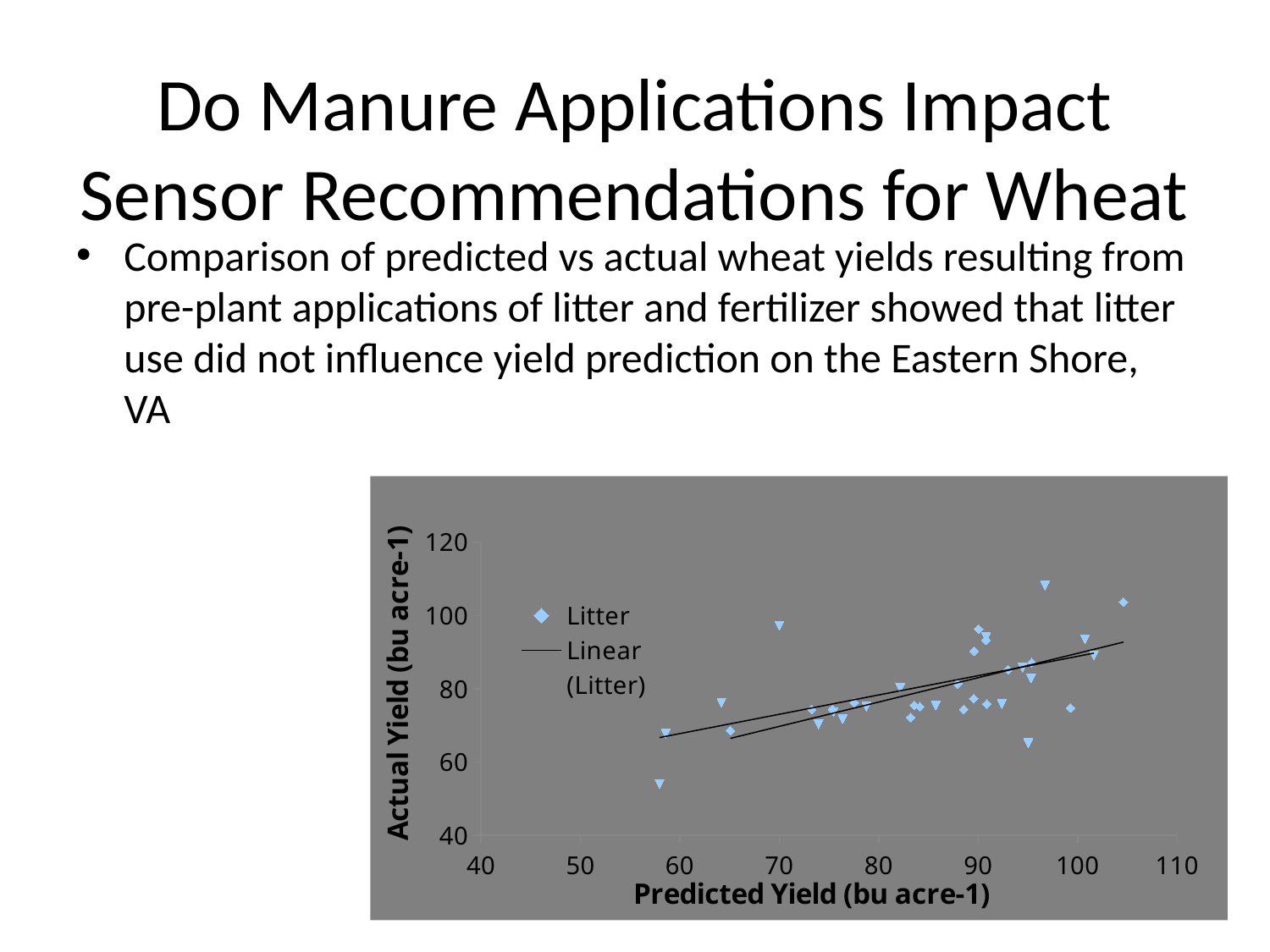
Is the smallest predicted yield plotted on the chart greater or less than 60? less What is the title of the y axis of the chart? Actual Yield (bu acre-1) How many entries does the chart legend list? 2 Does the linear trendline for Litter rise or fall as predicted yield increases along the x axis? rise Is the lowest actual yield plotted on the chart greater or less than 60? less What are the two entries listed in the chart legend? Litter and Linear (Litter) What kind of chart is shown on the slide? scatter chart Is the largest predicted yield plotted on the chart greater or less than 100? greater